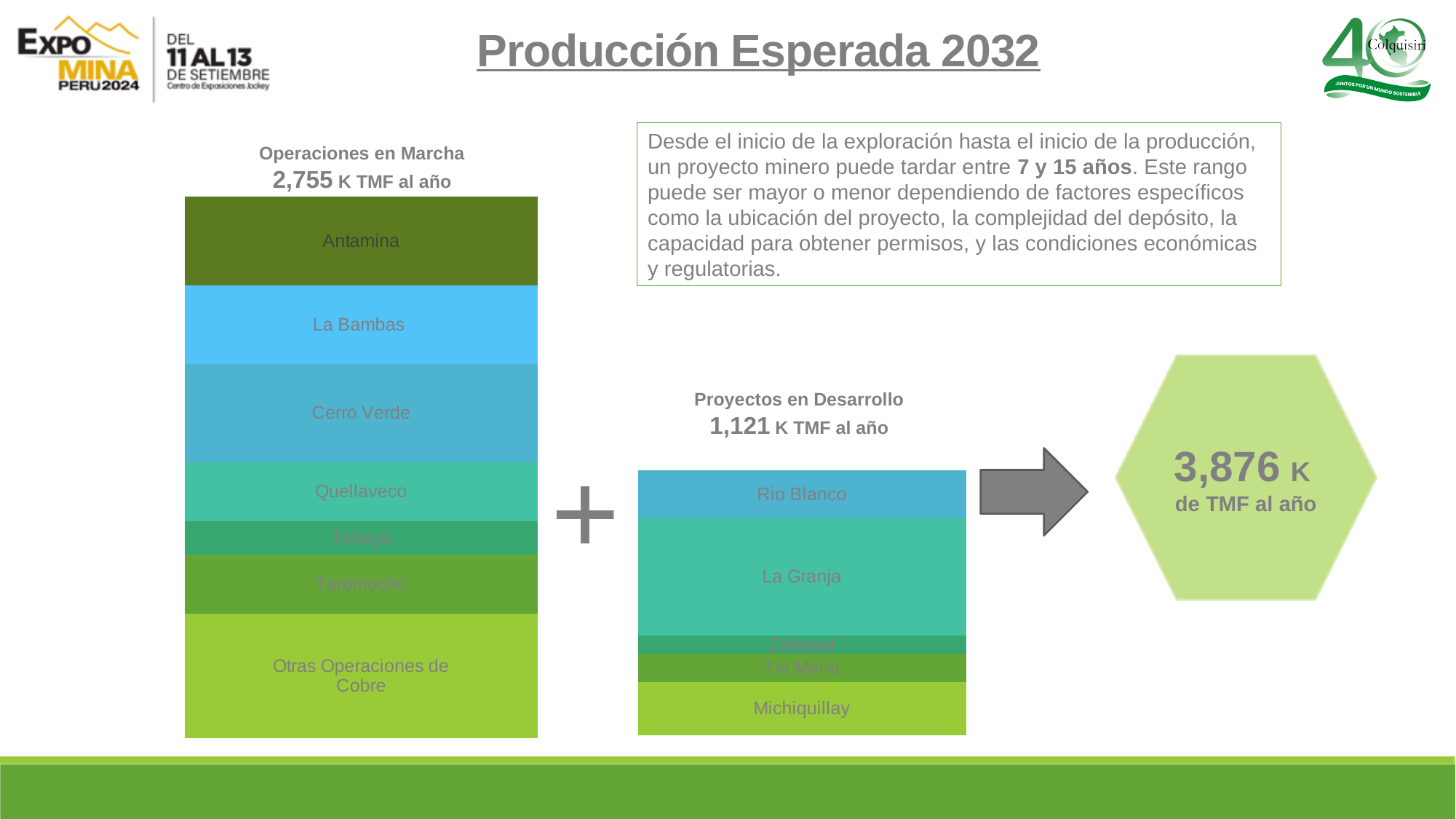
What combined production figure is shown in the hexagon to the right of the two stacked bars? 3,876 K de TMF al año What is the total annual production shown for the 'Proyectos en Desarrollo' stacked bar? 1,121 K TMF al año What is the total annual production shown for the 'Operaciones en Marcha' stacked bar? 2,755 K TMF al año What kind of chart is used to show 'Operaciones en Marcha'? Stacked bar chart In the 'Operaciones en Marcha' bar, which segment is the smallest? Tintaya What is the difference between the 'Operaciones en Marcha' total and the 'Proyectos en Desarrollo' total, in K TMF al año? 1,634 How many segments (operations) are stacked in the 'Operaciones en Marcha' bar? 7 Which segment is at the top of the 'Operaciones en Marcha' stacked bar? Antamina In the 'Operaciones en Marcha' bar, which segment is the largest? Otras Operaciones de Cobre How many segments (projects) are stacked in the 'Proyectos en Desarrollo' bar? 5 In the 'Operaciones en Marcha' bar, which segment is larger: Cerro Verde or Tintaya? Cerro Verde In the 'Proyectos en Desarrollo' bar, which segment is the largest? La Granja